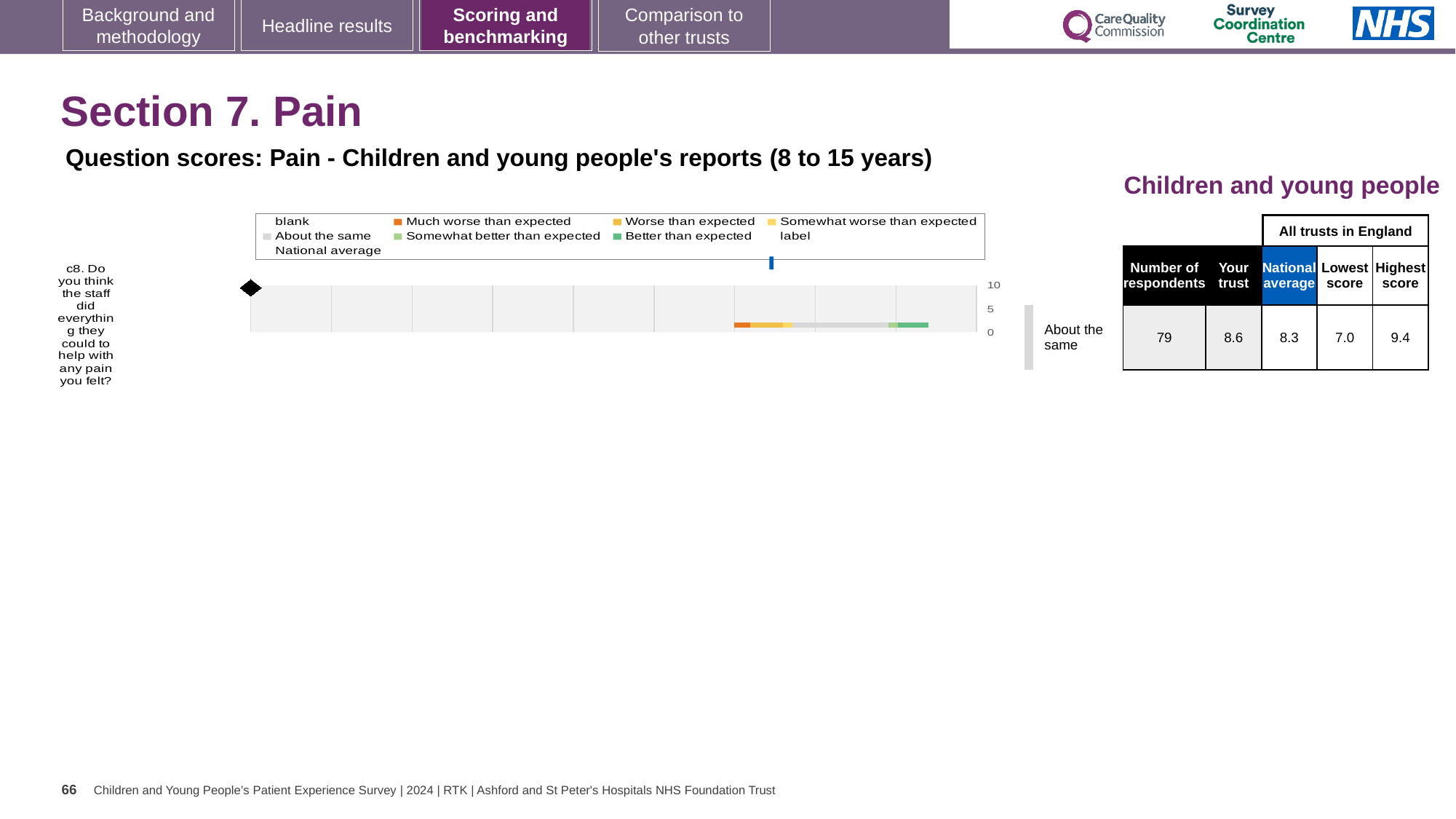
How many respondents answered question c8? 79 What benchmark category is the trust's result for question c8 assigned to? About the same Which is larger for question c8: the 'Your trust' score or the national average? Your trust What is the maximum value shown on the chart's numeric axis? 10 How many survey questions are plotted on the chart? 1 What is the lowest score among all trusts in England for question c8? 7.0 What is the national average score for question c8? 8.3 What is the difference between the 'Your trust' score and the national average for question c8? 0.3 What is the highest score among all trusts in England for question c8? 9.4 What is the difference between the highest and lowest scores for question c8? 2.4 What is the 'Your trust' score for question c8 (Do you think the staff did everything they could to help with any pain you felt?)? 8.6 What type of chart is shown on the slide? bar chart